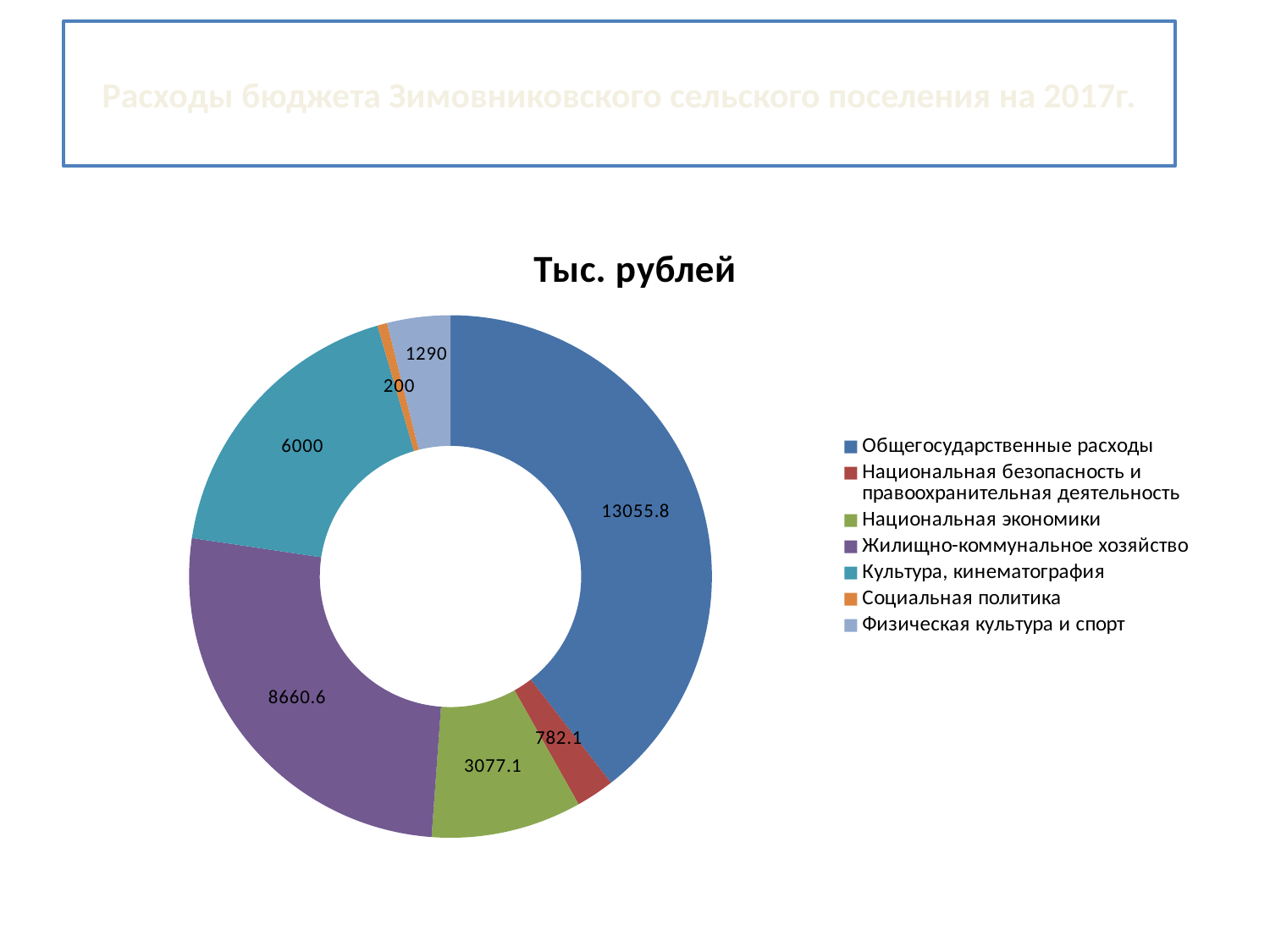
What is the difference between Общегосударственные расходы and Жилищно-коммунальное хозяйство? 4395.2 What is the value for Общегосударственные расходы? 13055.8 What is the value for Жилищно-коммунальное хозяйство? 8660.6 Which category has the highest value? Общегосударственные расходы Which is larger, Национальная экономики or Национальная безопасность и правоохранительная деятельность? Национальная экономики What is the value for Культура, кинематография? 6000 What is the title of the chart? Тыс. рублей How many categories does the chart show? 7 What is the difference between Культура, кинематография and Национальная экономики? 2922.9 What is the value for Физическая культура и спорт? 1290 What is the value for Социальная политика? 200 Which category has the lowest value? Социальная политика